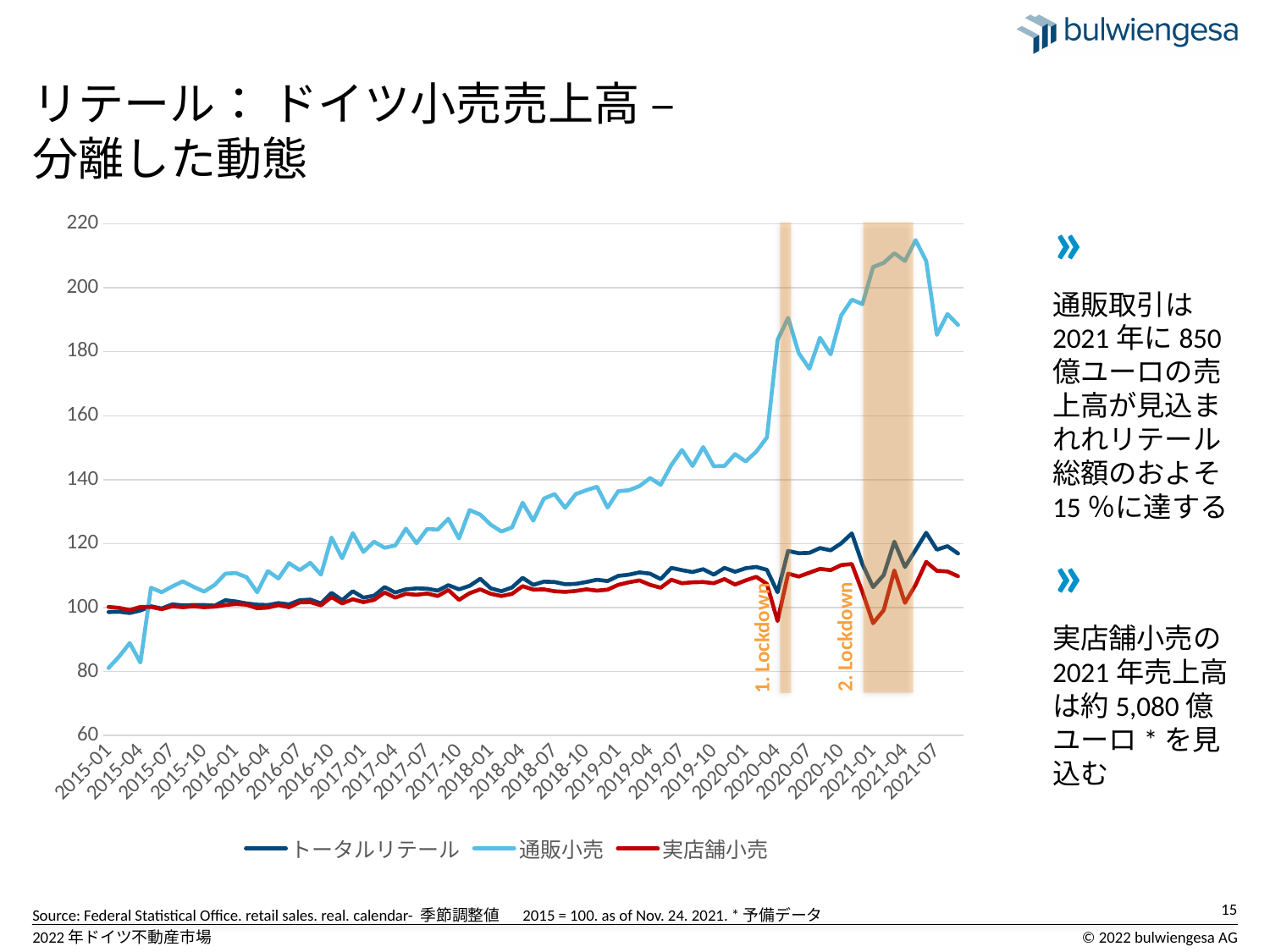
Which series has the lowest value at the right end of the chart (2021-07 onward)? 実店舗小売 Which series is shown in red in the legend? 実店舗小売 At 2021-04, which series has the higher value, 通販小売 or 実店舗小売? 通販小売 What are the two shaded periods on the chart labelled? 1. Lockdown and 2. Lockdown Is the value for 通販小売 at 2015-01 greater or less than 100? less Is the value for 通販小売 at 2018-01 greater or less than 120? greater How many series does the legend list? 3 Does the 通販小売 series generally rise or fall from 2015-01 to 2021-04? rise Is the value for 通販小売 at 2021-04 greater or less than 200? greater What kind of chart is shown on the slide? line chart